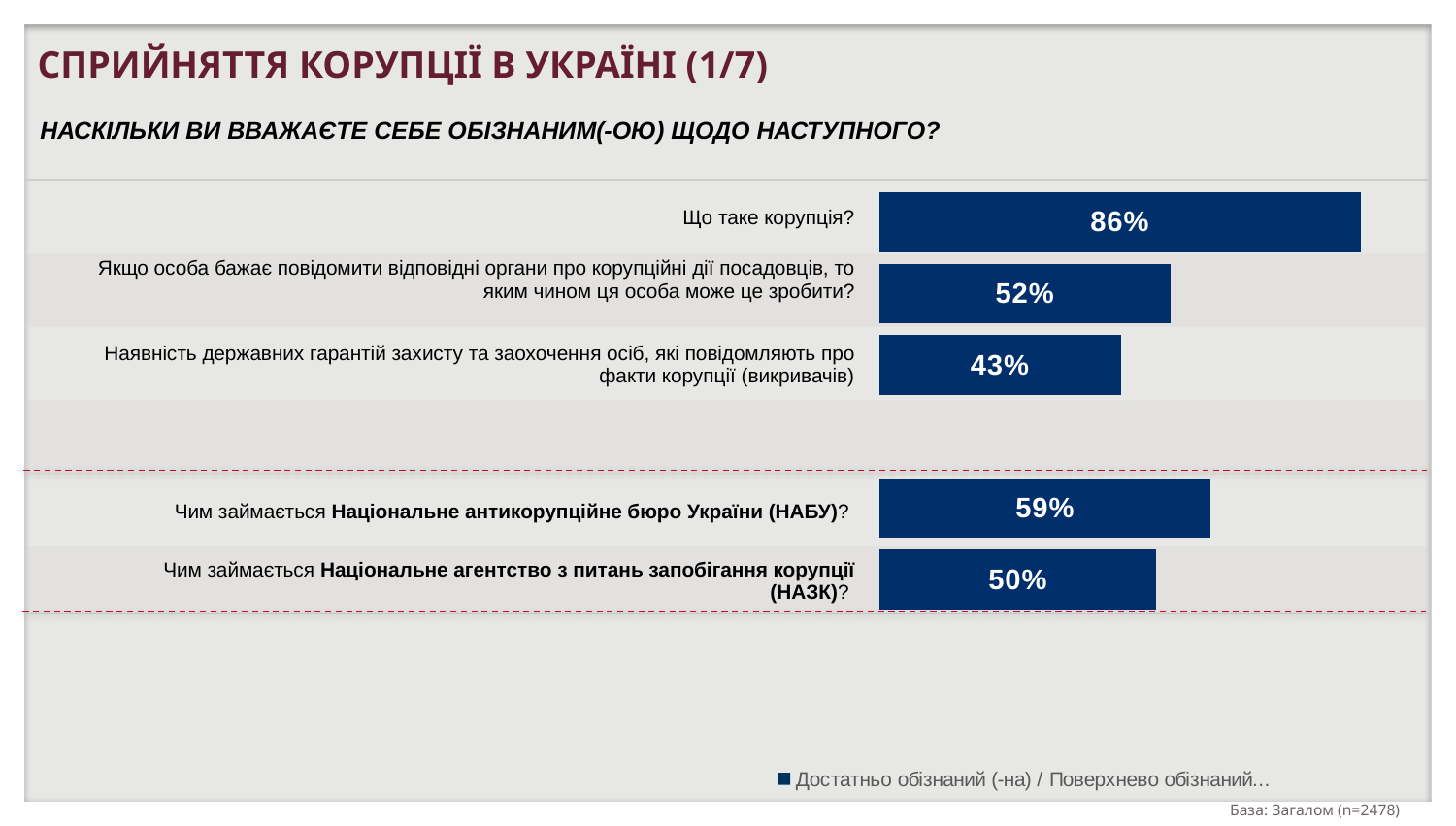
What is the difference between the НАБУ value and the НАЗК value? 9% What is the value for the category about what the National Agency on Corruption Prevention (НАЗК) does? 50% What is the value for the category about the existence of state guarantees of protection and encouragement for whistleblowers (викривачів)? 43% How many series does the legend list? 1 Which category has the highest value on the chart? Що таке корупція? What is the value for the category about what the National Anti-Corruption Bureau of Ukraine (НАБУ) does? 59% What is the difference between the value for "Що таке корупція?" and the value for the НАБУ category? 27% How many categories (bars) are shown on the chart? 5 Which category has the lowest value on the chart? Наявність державних гарантій захисту та заохочення осіб, які повідомляють про факти корупції (викривачів) What kind of chart is shown on the slide? Bar chart Which is larger: the value for how a person can report corrupt actions of officials, or the value for the НАЗК category? How a person can report corrupt actions of officials (52%) What percentage of respondents consider themselves informed about what corruption is ("Що таке корупція?")? 86%